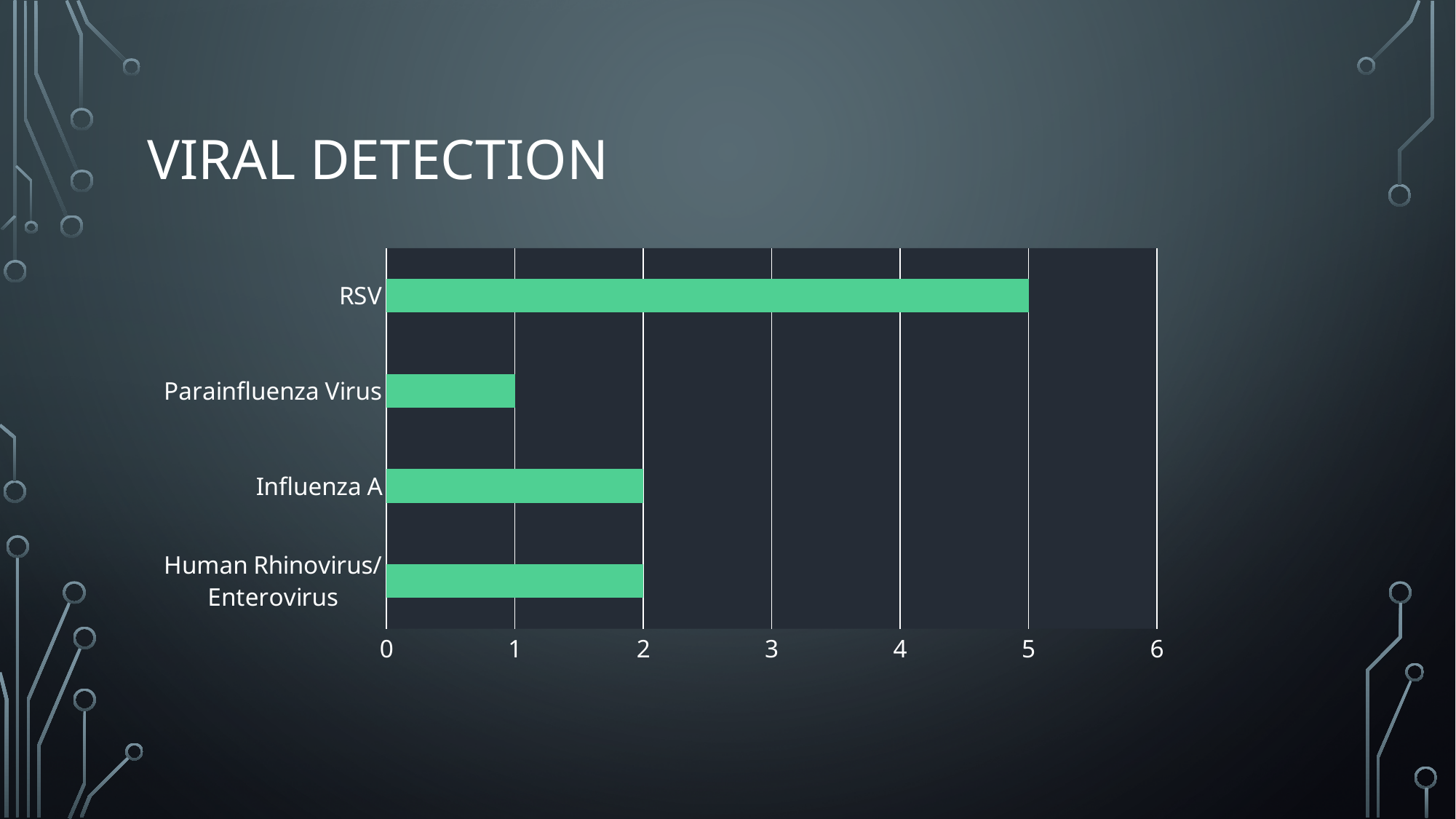
What is the difference between the values for RSV and Influenza A? 3 What kind of chart is shown on the slide? Bar chart How many categories are shown in the chart? 4 What is the value for Influenza A? 2 Which is larger, the value for RSV or the value for Parainfluenza Virus? RSV Which category has the highest value? RSV Which category has the lowest value? Parainfluenza Virus What is the difference between the values for Influenza A and Parainfluenza Virus? 1 What is the value for Parainfluenza Virus? 1 What is the value for RSV? 5 Is the value for RSV greater or less than 4? greater What is the value for Human Rhinovirus/Enterovirus? 2